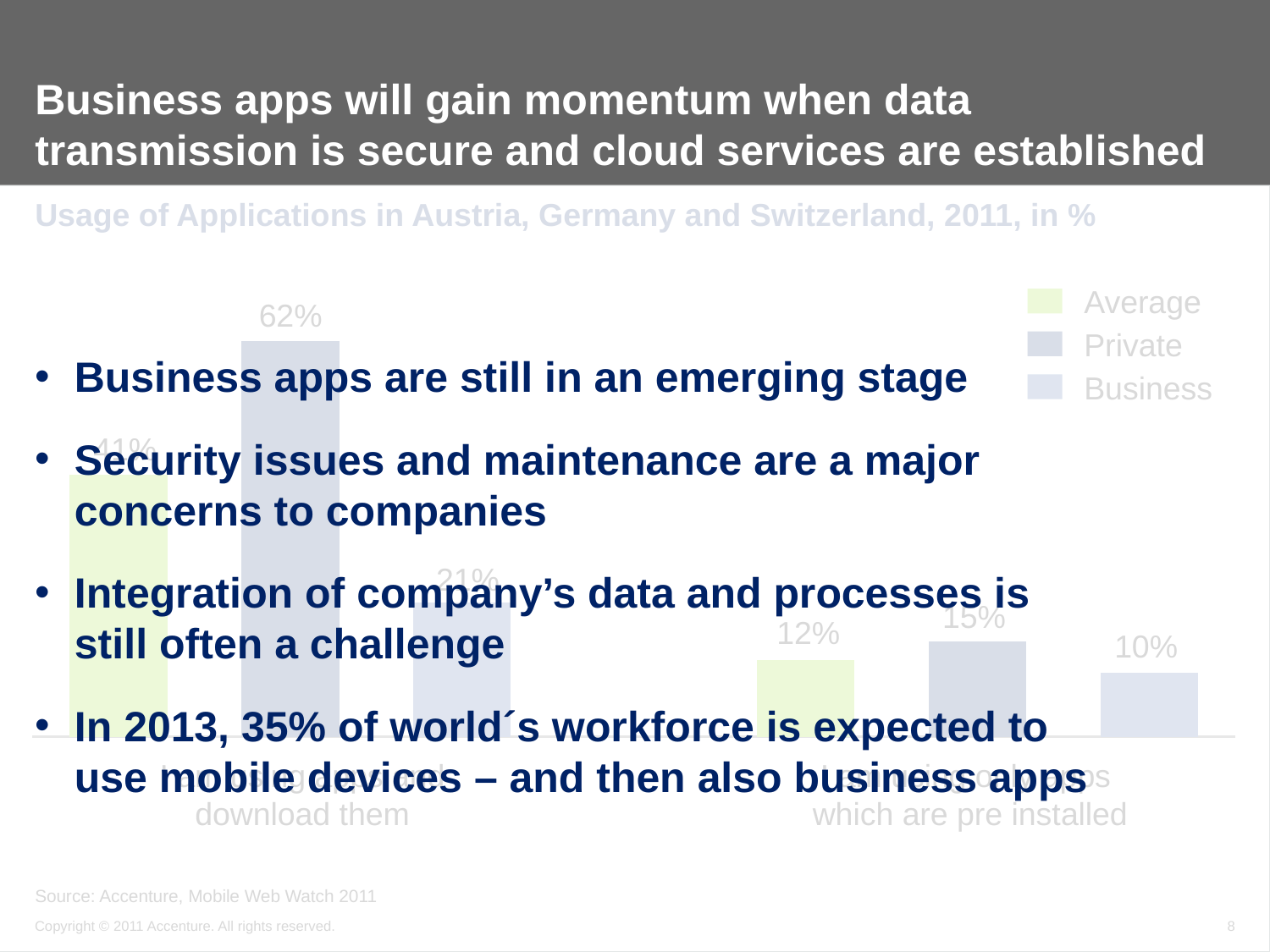
What is the value of the Business bar in the left group of bars? 21% What is the value of the Average bar in the right group of bars? 12% What is the value of the Private bar in the left group of bars? 62% Which bar has the highest value in the chart? Private in the left group (62%) Which bar has the lowest value in the chart? Business in the right group (10%) What are the three series named in the chart legend? Average, Private, Business How many series does the chart legend list? 3 How many groups of bars (categories) does the chart show? 2 What is the value of the Private bar in the right group of bars? 15% What kind of chart is shown on the slide? bar chart What is the value of the Business bar in the right group of bars? 10% What is the difference between the Private and Business values in the right group of bars? 5%